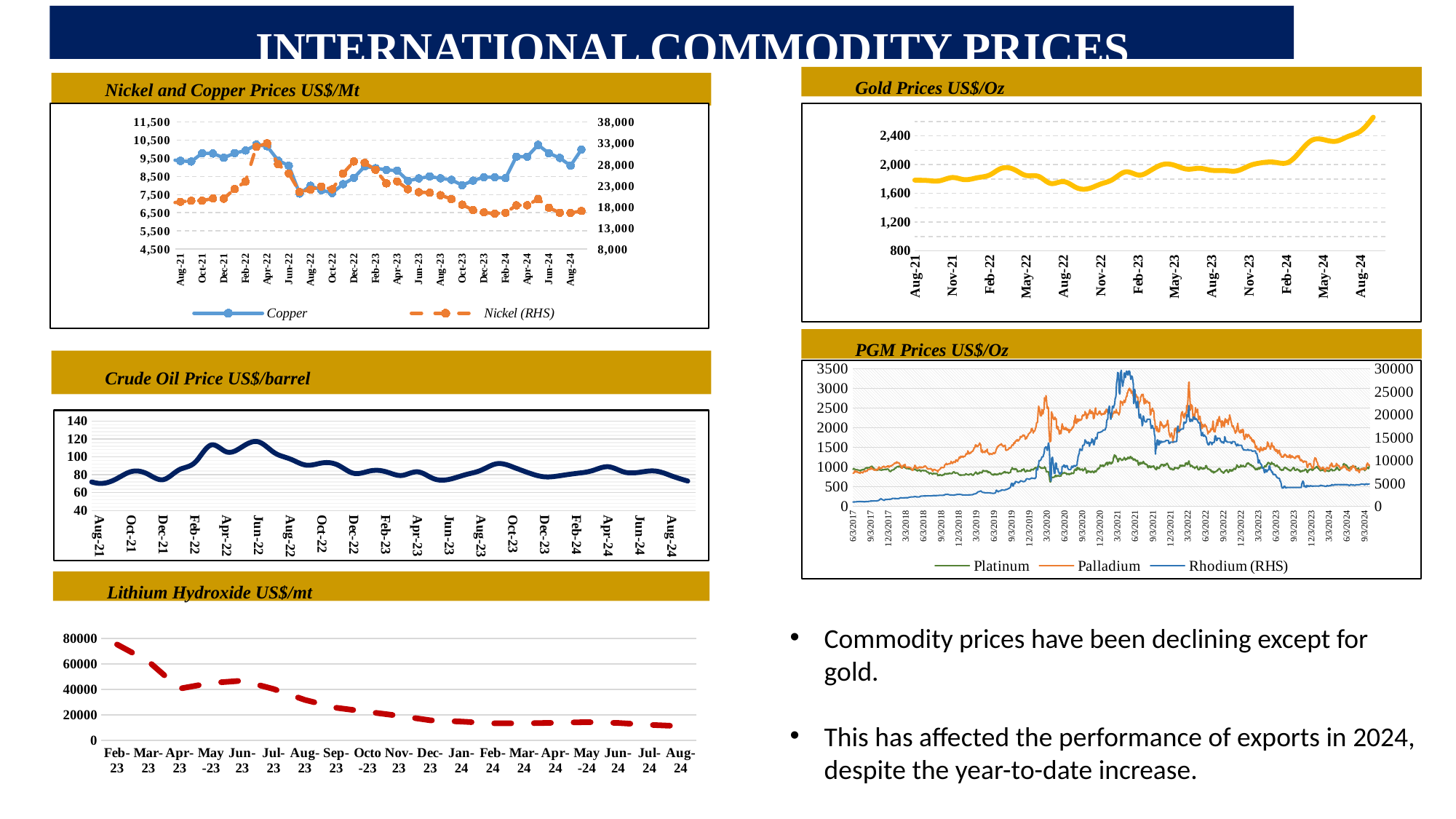
In the Lithium Hydroxide US$/mt chart, is the value for Aug-24 greater or less than 20000? less In the PGM Prices US$/Oz chart, which series is plotted on the right-hand axis? Rhodium In the Gold Prices US$/Oz chart, do gold prices rise or fall overall from Aug-21 to Aug-24? Rise In the Lithium Hydroxide US$/mt chart, is the value for Feb-23 greater or less than 60000? greater In the Lithium Hydroxide US$/mt chart, does the price rise or fall overall from Feb-23 to Aug-24? Fall How many series does the legend of the PGM Prices US$/Oz chart list? 3 What kind of chart is the Gold Prices US$/Oz chart? Line chart In the Crude Oil Price US$/barrel chart, is the value for Jun-22 greater or less than 100? greater How many months are shown on the x axis of the Lithium Hydroxide US$/mt chart? 19 What kind of chart is the Crude Oil Price US$/barrel chart? Line chart How many series does the legend of the Nickel and Copper Prices US$/Mt chart list? 2